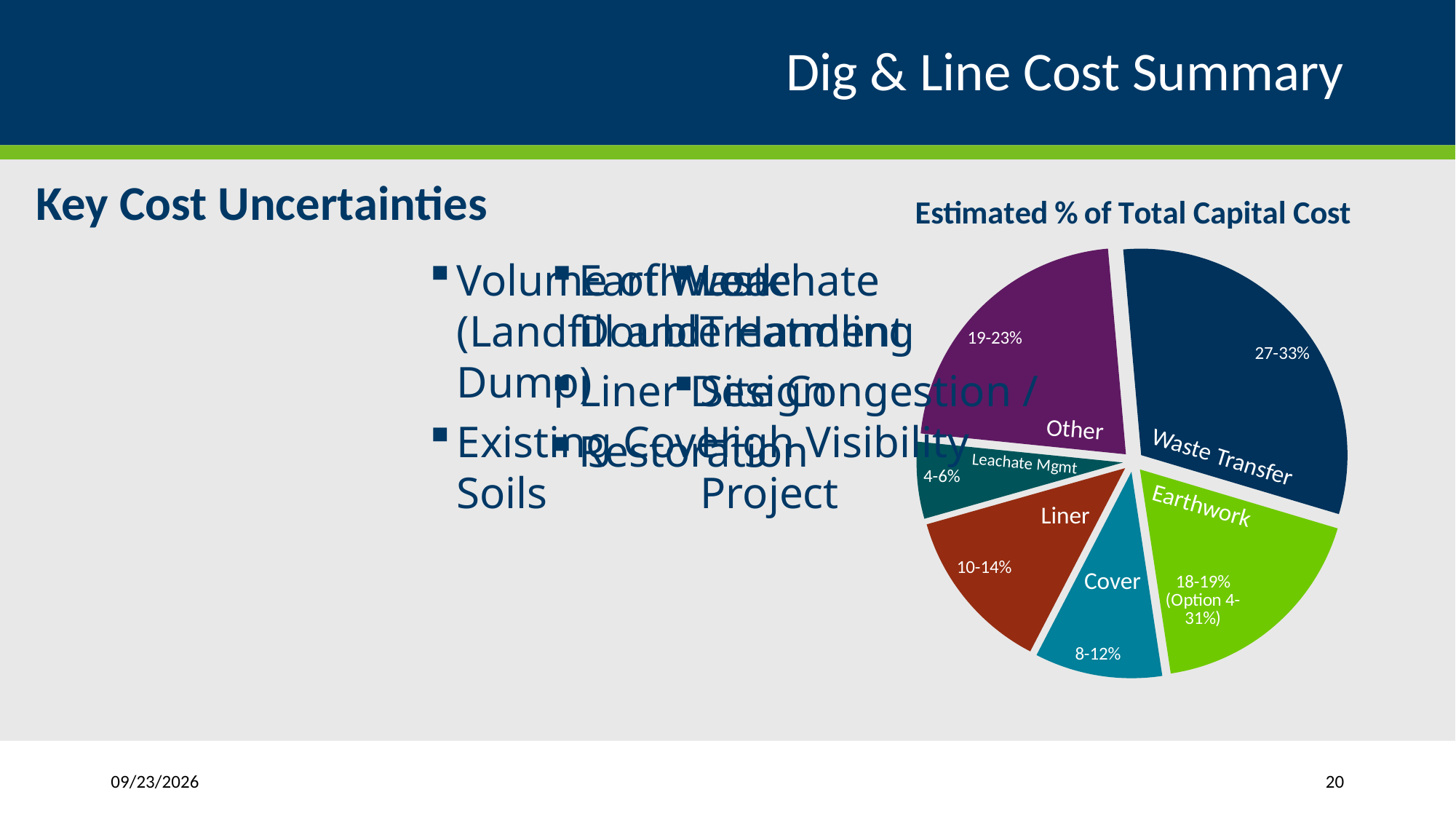
Which slice of the pie chart represents the smallest share of total capital cost? Leachate Mgmt What estimated percentage of total capital cost is shown for Waste Transfer? 27-33% What estimated percentage of total capital cost is shown for Liner? 10-14% Which slice of the pie chart represents the largest share of total capital cost? Waste Transfer Which has a larger share of total capital cost, Other or Liner? Other What is the title of the pie chart? Estimated % of Total Capital Cost How many slices does the pie chart have? 6 What estimated percentage of total capital cost is shown for Cover? 8-12% What type of chart is shown on the slide? pie chart What estimated percentage of total capital cost is shown for Leachate Mgmt? 4-6% What label is printed on the Earthwork slice of the pie chart? 18-19% (Option 4-31%) What estimated percentage of total capital cost is shown for Other? 19-23%